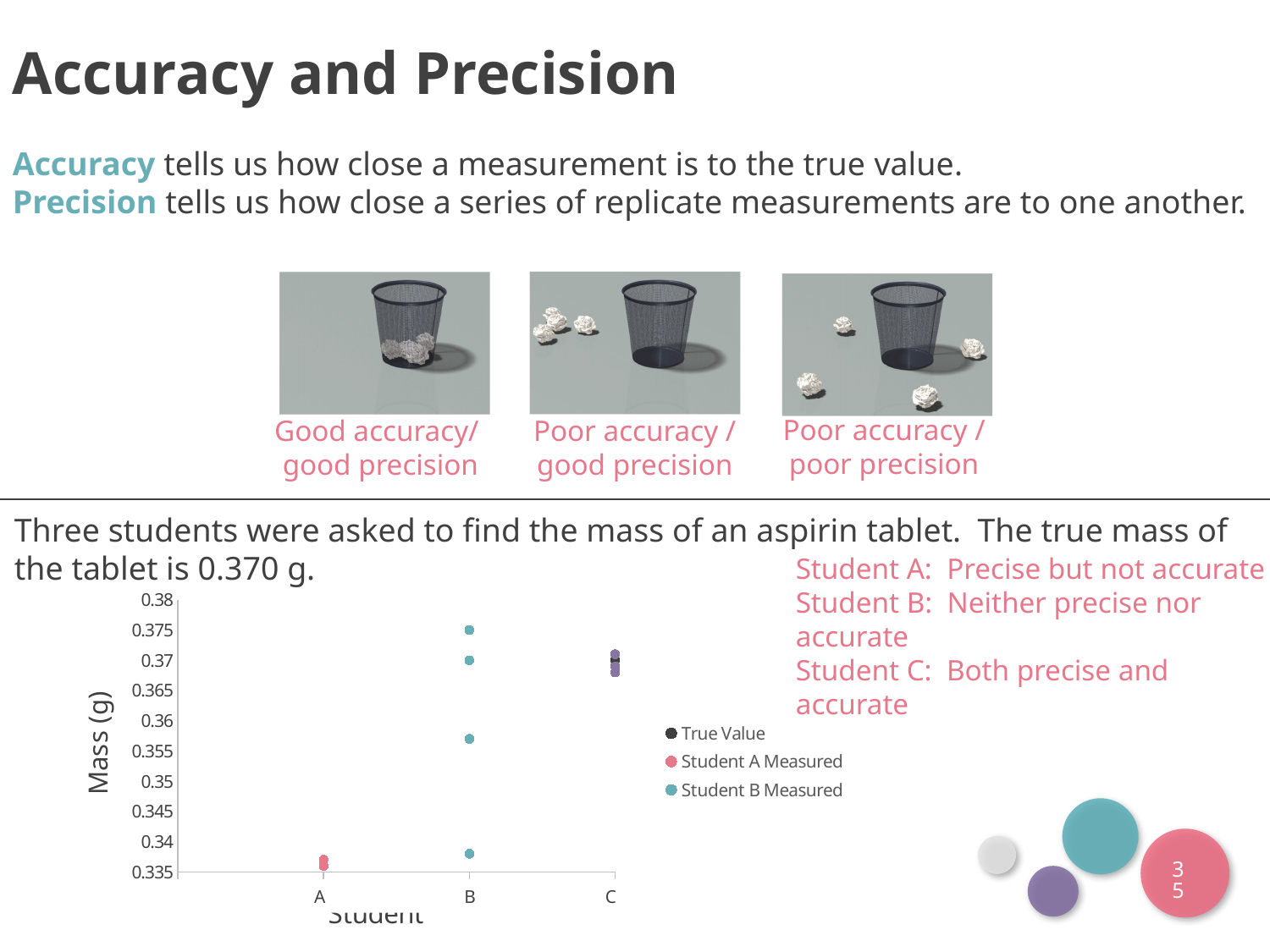
How many series does the chart's legend list? 3 Are the measured values for Student A greater or less than 0.34? less Is the lowest measured value for Student B greater or less than 0.34? less What kind of chart is shown on the slide? scatter chart Are the measured values for Student C greater or less than 0.365? greater How many students (categories) are shown on the x axis of the chart? 3 What is the title of the chart's y axis? Mass (g) Which student has the lowest measured values on the chart? A What is the first entry in the chart's legend? True Value Which student's measurements are higher on the chart, Student A's or Student C's? Student C